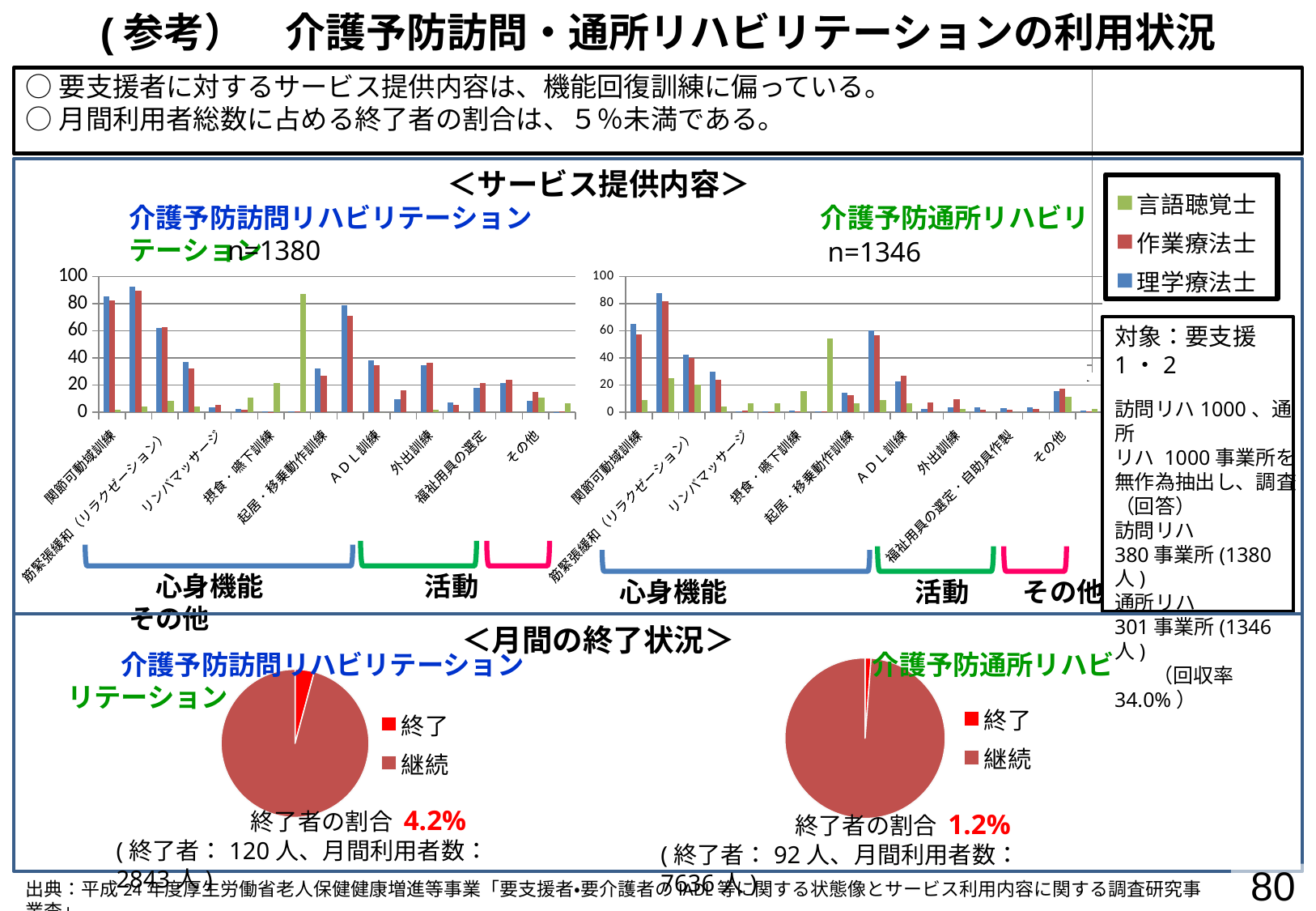
In the 介護予防通所リハビリテーション pie chart under ＜月間の終了状況＞, what share is 終了? 1.2% In the 介護予防訪問リハビリテーション pie chart under ＜月間の終了状況＞, what share is 終了? 4.2% In the 介護予防訪問リハビリテーション bar chart, is the 言語聴覚士 value for 起居・移乗動作訓練 greater or less than 60? less How many series does the legend for the ＜サービス提供内容＞ bar charts list? 3 In the 介護予防通所リハビリテーション bar chart, is the 言語聴覚士 value for 起居・移乗動作訓練 greater or less than 40? less Which pie chart under ＜月間の終了状況＞ has the larger 終了 share, 介護予防訪問リハビリテーション or 介護予防通所リハビリテーション? 介護予防訪問リハビリテーション What kind of chart is used under ＜月間の終了状況＞? pie chart What kind of chart is the 介護予防訪問リハビリテーション chart under ＜サービス提供内容＞? bar chart In the 介護予防訪問リハビリテーション bar chart, is the 理学療法士 value for 関節可動域訓練 greater or less than 60? greater